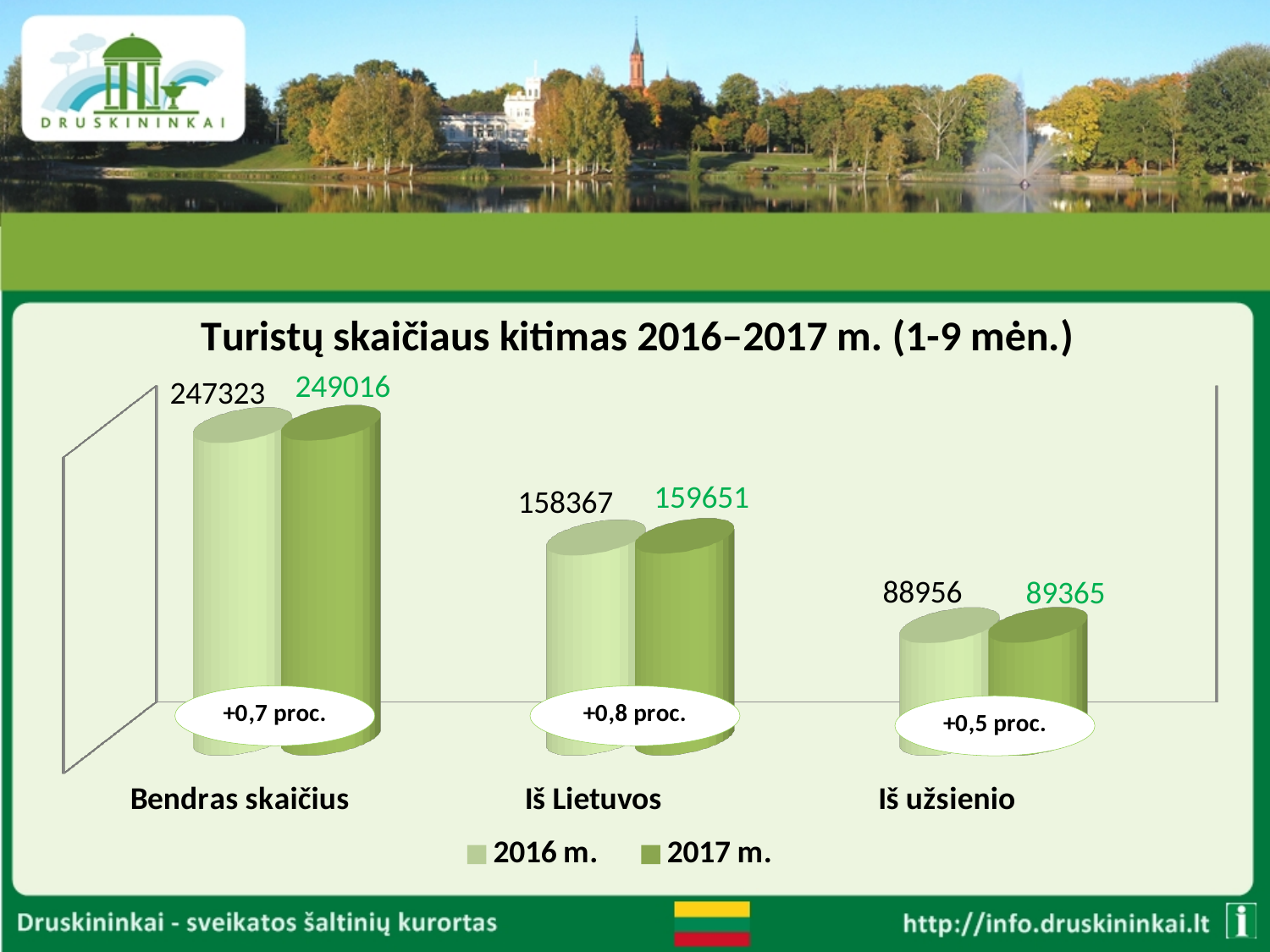
What is the value for 2017 m. in the Iš užsienio category? 89365 Which category has the highest value for 2016 m.? Bendras skaičius What is the value for 2016 m. in the Iš užsienio category? 88956 Which category has the lowest value for 2017 m.? Iš užsienio What is the value for 2017 m. in the Iš Lietuvos category? 159651 How many categories are shown on the x axis? 3 What percentage change is shown in the label for the Iš Lietuvos category? +0,8 proc. What kind of chart is shown on the slide? Bar chart What is the difference between the 2017 m. and 2016 m. values for Bendras skaičius? 1693 How many series does the legend list? 2 What is the difference between the 2017 m. and 2016 m. values for Iš užsienio? 409 What is the value for 2016 m. in the Bendras skaičius category? 247323